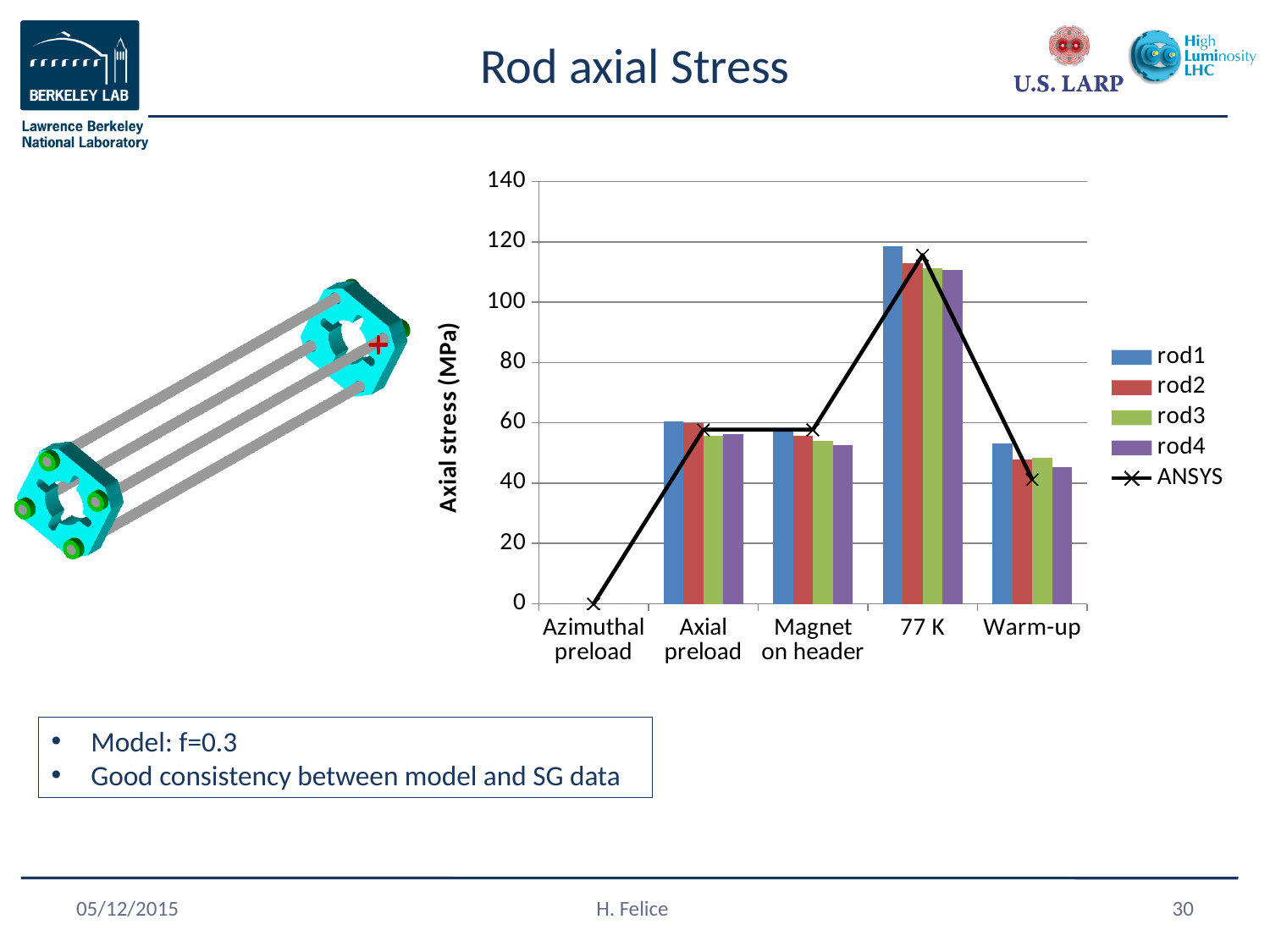
Which series in the legend is drawn as a line with x markers? ANSYS For which category is the ANSYS value lowest? Azimuthal preload Do the ANSYS values rise or fall from Magnet on header to 77 K? rise Is the rod4 value at Magnet on header greater or less than 60? less What kind of chart is shown on the slide? bar chart with a line series How many series does the chart legend list? 5 For which category is the rod1 value highest? 77 K What is the y-axis title of the chart? Axial stress (MPa) How many categories are shown on the x axis of the chart? 5 What is the ANSYS value at Azimuthal preload? 0 Which is larger, the rod1 value at 77 K or the rod1 value at Warm-up? 77 K Is the rod1 value at 77 K greater or less than 100? greater